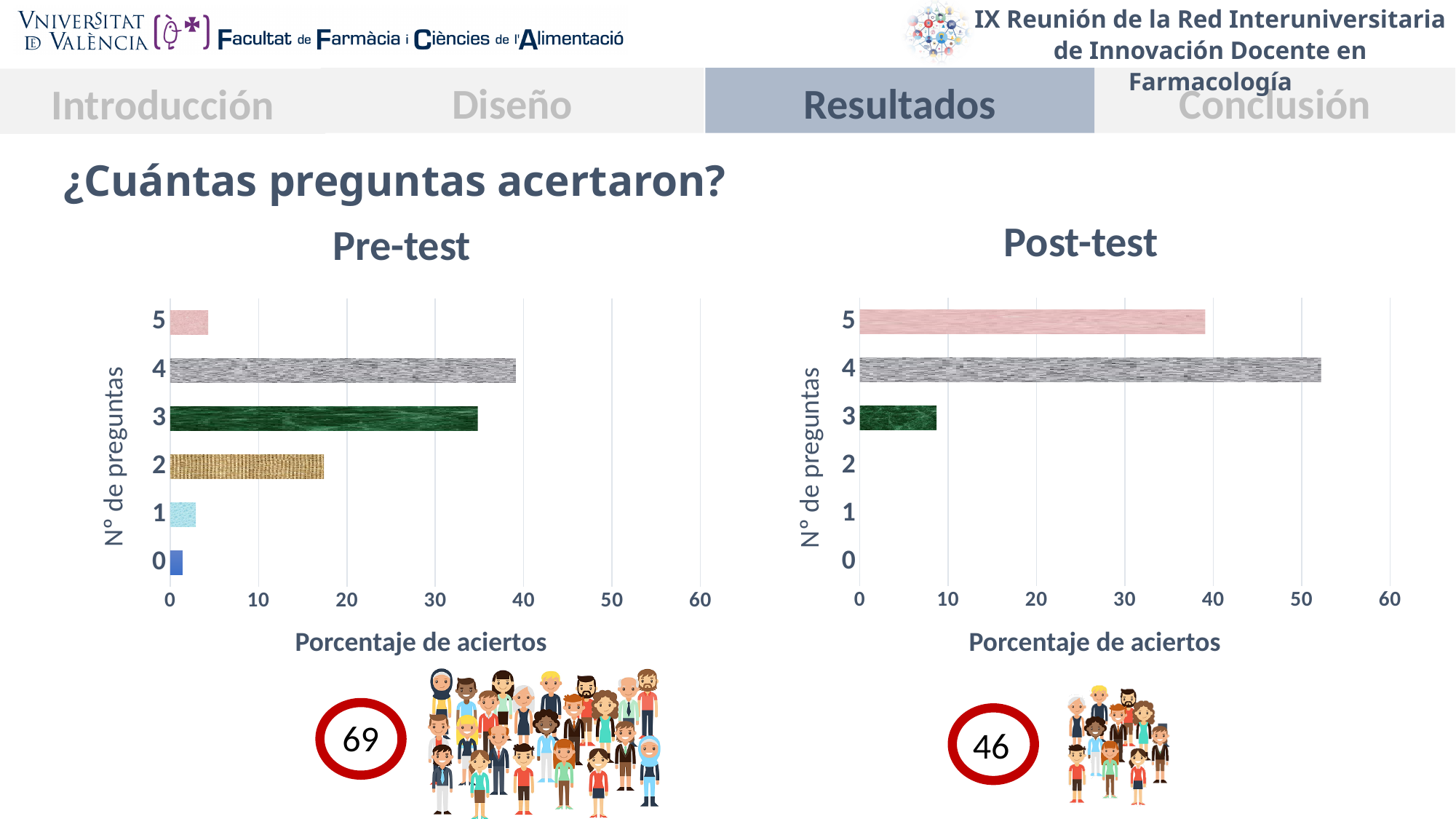
In the Pre-test chart, which number of questions has the highest percentage? 4 Which chart shows the larger value for 5 questions, Pre-test or Post-test? Post-test In the Pre-test chart, is the value for 2 questions greater or less than 20? less In the Post-test chart, is the value for 3 questions greater or less than 10? less In the Post-test chart, which number of questions has the highest percentage? 4 In the Pre-test chart, which is larger: the value for 3 questions or for 2 questions? 3 questions In the Post-test chart, is the value for 4 questions greater or less than 50? greater In the Pre-test chart, which number of questions has the lowest percentage? 0 How many categories are shown on the y axis of the Post-test chart? 6 What kind of chart is the Pre-test chart? bar chart What is the x-axis label of the Post-test chart? Porcentaje de aciertos